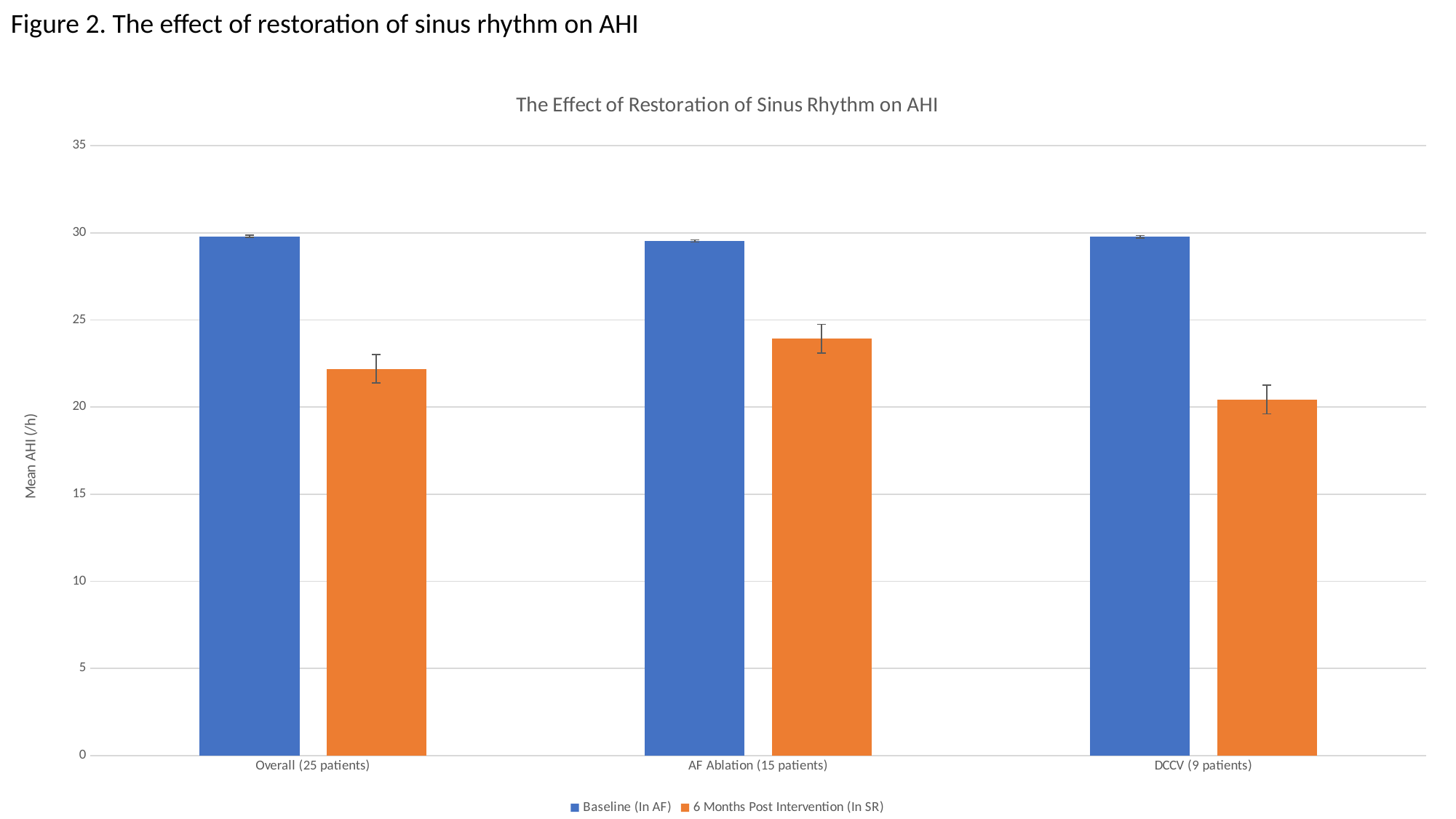
Is the Baseline (In AF) value for Overall (25 patients) greater or less than 25? greater Is the 6 Months Post Intervention (In SR) value for Overall (25 patients) greater or less than 25? less What is the label of the y axis? Mean AHI (/h) Is the 6 Months Post Intervention (In SR) value for AF Ablation (15 patients) greater or less than 20? greater What kind of chart is shown on the slide? bar chart How many series does the legend list? 2 Which group has the lowest 6 Months Post Intervention (In SR) value? DCCV (9 patients) For Overall (25 patients), which is larger: the Baseline (In AF) value or the 6 Months Post Intervention (In SR) value? Baseline (In AF) How many patient groups are shown on the x axis? 3 Which group has the highest 6 Months Post Intervention (In SR) value? AF Ablation (15 patients) What is the title of the chart? The Effect of Restoration of Sinus Rhythm on AHI